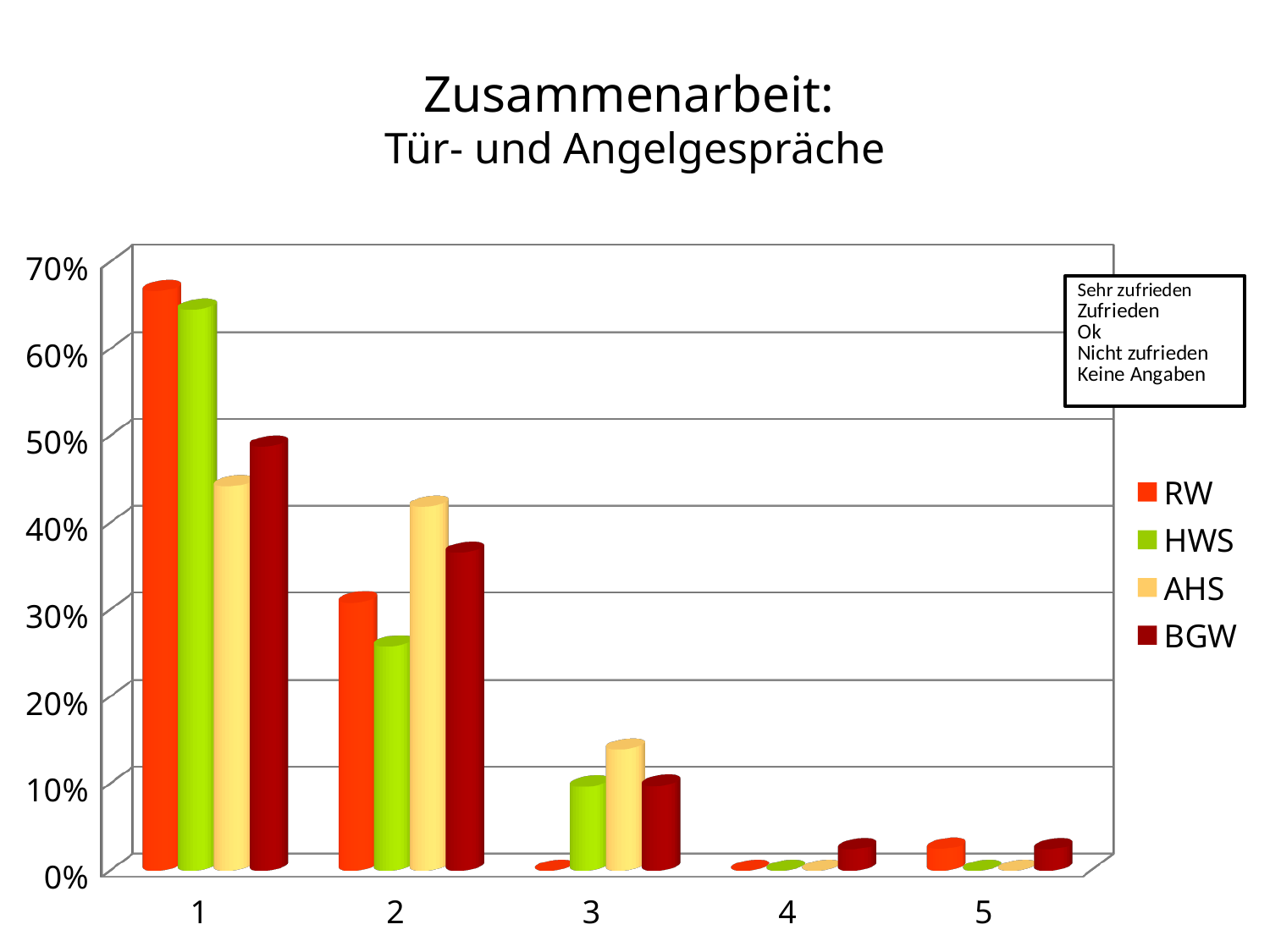
Do the values for RW rise or fall from category 1 to category 3? fall How many categories are shown on the x axis? 5 Is the value for AHS in category 3 greater or less than 10%? greater Which series has the highest value in category 3? AHS Is the value for RW in category 1 greater or less than 60%? greater In category 1, which is larger: the value for RW or the value for AHS? RW Is the value for BGW in category 2 greater or less than 40%? less Which series has the lowest value in category 2? HWS What kind of chart is shown on the slide? bar chart How many series does the legend list? 4 Which series has the highest value in category 2? AHS